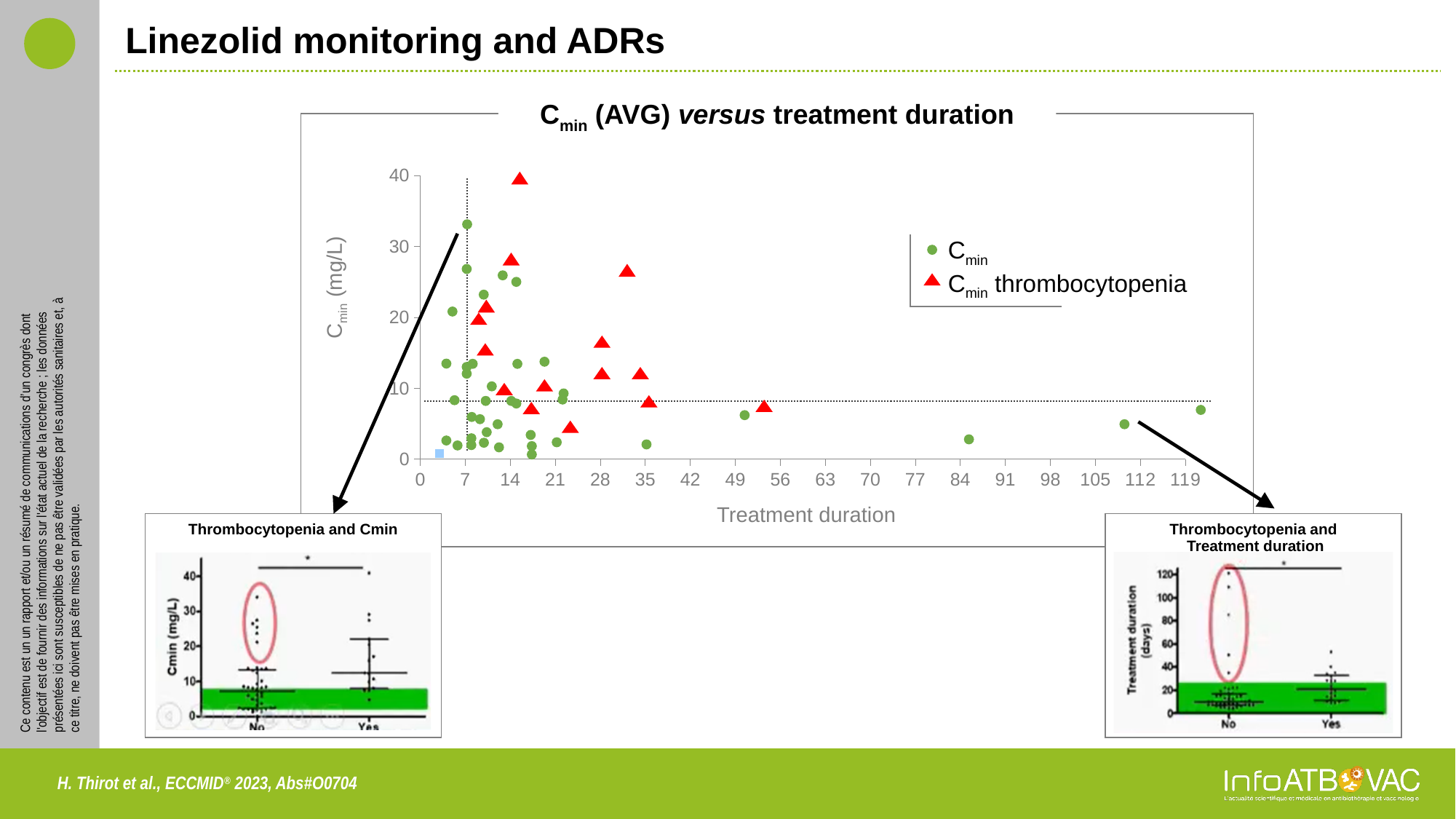
How many series does the legend of the 'Cmin (AVG) versus treatment duration' chart list? 2 In the 'Cmin (AVG) versus treatment duration' chart, is the Cmin value of the red triangle near 32 days greater or less than 20? greater What is the x-axis label of the 'Cmin (AVG) versus treatment duration' chart? Treatment duration In the 'Cmin (AVG) versus treatment duration' chart, is the Cmin value of the highest green circle greater or less than 30? greater What kind of chart is 'Cmin (AVG) versus treatment duration'? scatter chart In the 'Cmin (AVG) versus treatment duration' chart, which series extends to the longest treatment durations? Cmin In the 'Cmin (AVG) versus treatment duration' chart, which series contains the point with the highest Cmin value? Cmin thrombocytopenia In the 'Cmin (AVG) versus treatment duration' chart, is the Cmin value of the green point near 85 days greater or less than 5? less What are the two legend entries in the 'Cmin (AVG) versus treatment duration' chart? Cmin and Cmin thrombocytopenia